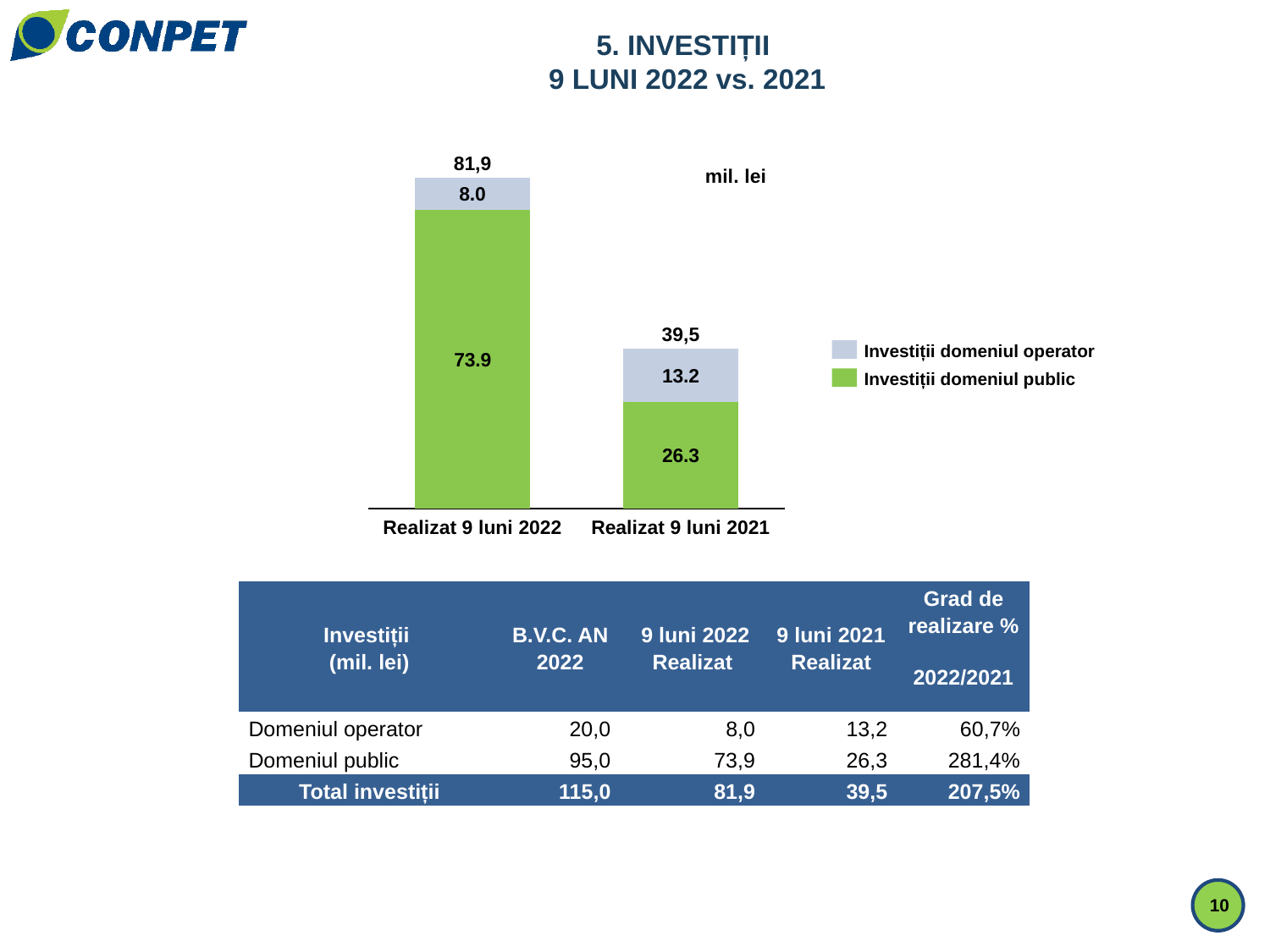
How many categories are shown on the x axis of the chart? 2 What unit is indicated on the chart? mil. lei How many series does the chart legend list? 2 What is the value of Investiții domeniul operator for Realizat 9 luni 2021? 13.2 What is the value of Investiții domeniul operator for Realizat 9 luni 2022? 8.0 What is the total of the stacked bar for Realizat 9 luni 2022? 81,9 What is the value of Investiții domeniul public for Realizat 9 luni 2022? 73.9 Which category has the higher total, Realizat 9 luni 2022 or Realizat 9 luni 2021? Realizat 9 luni 2022 What is the difference between the Investiții domeniul operator values for Realizat 9 luni 2021 and Realizat 9 luni 2022? 5.2 What is the difference between the Investiții domeniul public values for Realizat 9 luni 2022 and Realizat 9 luni 2021? 47.6 What type of chart is shown on the slide? Stacked bar chart What is the total of the stacked bar for Realizat 9 luni 2021? 39,5